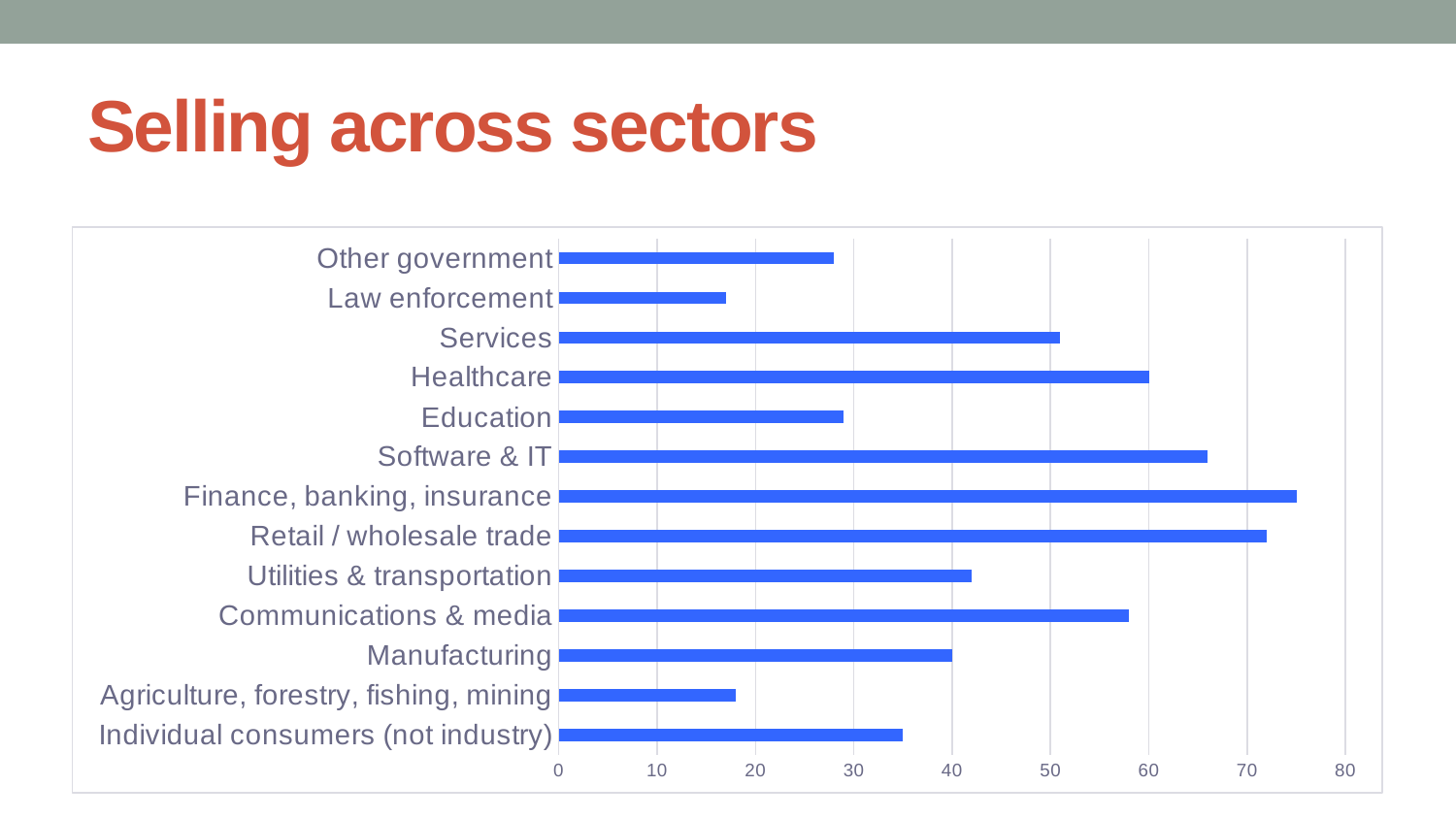
Is the value for Healthcare greater or less than 50? greater Is the value for Individual consumers (not industry) greater or less than 30? greater What is the title of the slide containing the chart? Selling across sectors Is the value for Finance, banking, insurance greater or less than 70? greater What kind of chart is shown on the slide? bar chart Which has the larger value, Healthcare or Services? Healthcare Which has the larger value, Software & IT or Communications & media? Software & IT How many sectors are plotted in the chart? 13 Which sector has the highest value in the chart? Finance, banking, insurance